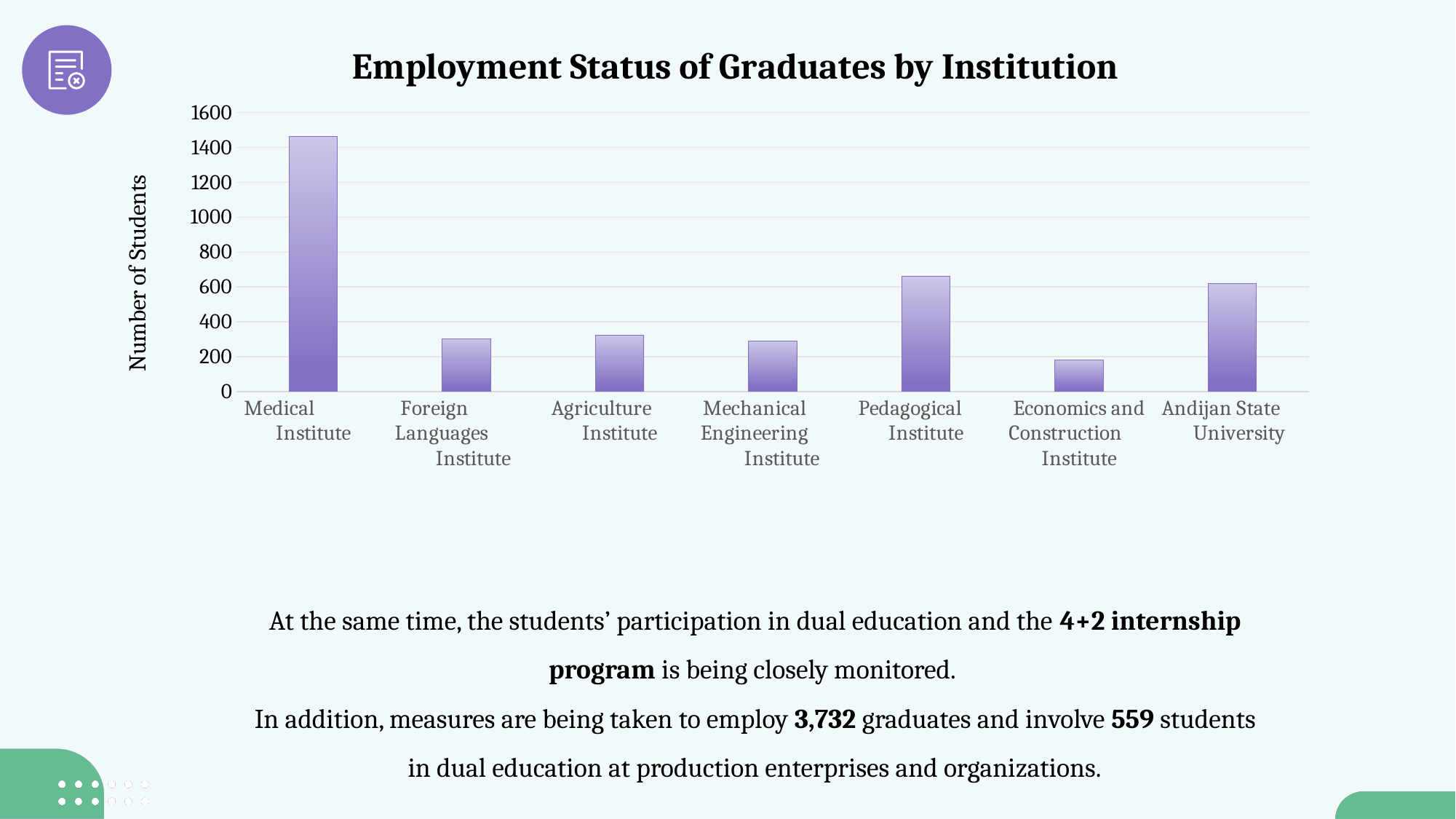
Is the value for Medical Institute greater or less than 1400? greater Is the value for Mechanical Engineering Institute greater or less than 400? less Which has more students, Medical Institute or Pedagogical Institute? Medical Institute What is the label of the vertical axis? Number of Students Is the value for Pedagogical Institute greater or less than 600? greater What type of chart is shown on the slide? Bar chart Which institution has the highest number of students? Medical Institute What is the title of the chart? Employment Status of Graduates by Institution Which has more students, Andijan State University or Foreign Languages Institute? Andijan State University Which institution has the lowest number of students? Economics and Construction Institute How many institutions are shown on the chart? 7